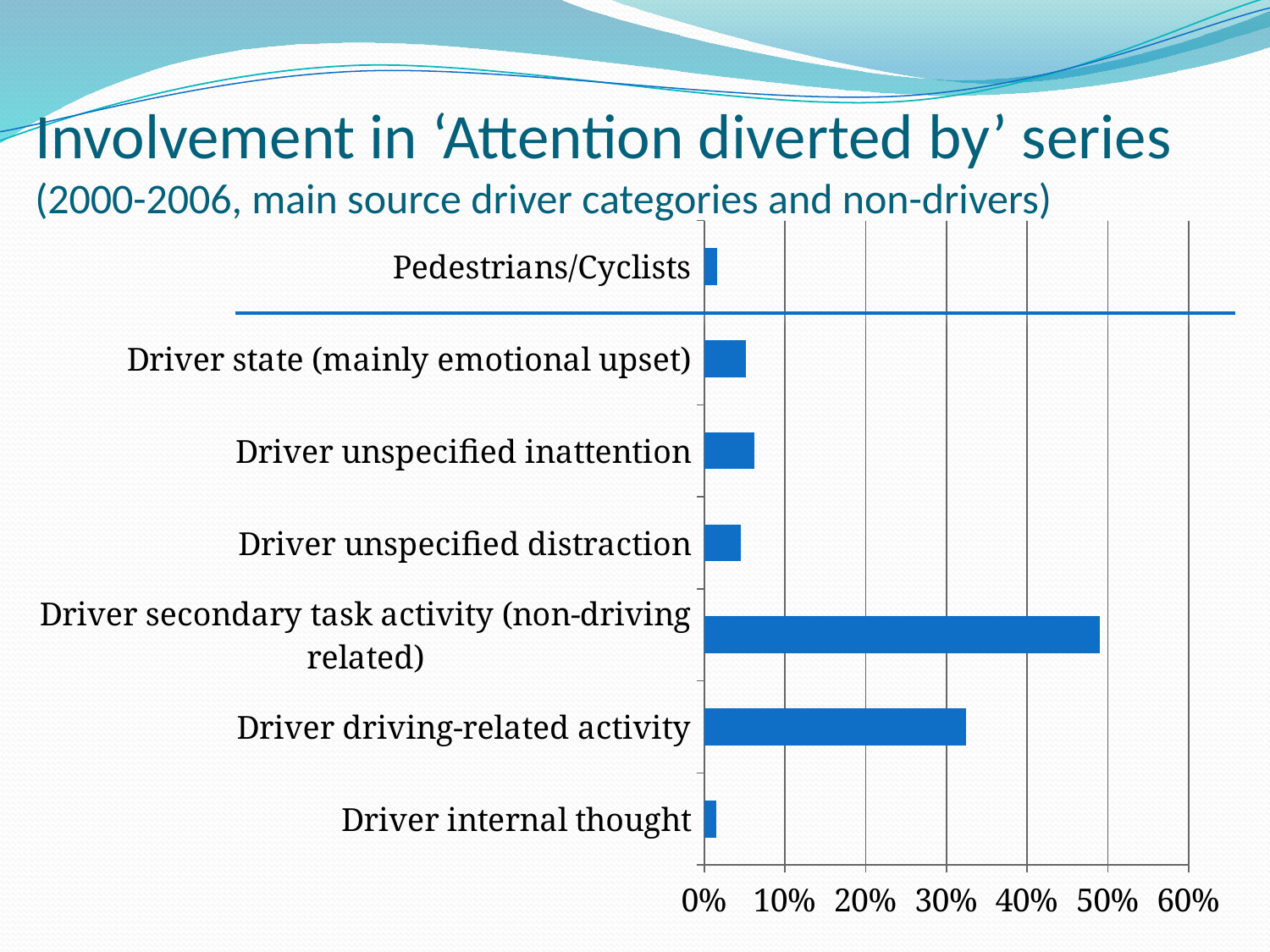
Is the value for Driver state (mainly emotional upset) greater or less than 10%? less What kind of chart is shown on the slide? bar chart Is the value for Driver driving-related activity greater or less than 40%? less Is the value for Driver secondary task activity (non-driving related) greater or less than 40%? greater Which category has the highest value in the chart? Driver secondary task activity (non-driving related) Which is larger: the value for Driver secondary task activity (non-driving related) or the value for Driver driving-related activity? Driver secondary task activity (non-driving related) What is the highest value shown on the horizontal axis of the chart? 60% Which is larger: the value for Driver driving-related activity or the value for Driver unspecified inattention? Driver driving-related activity How many categories are plotted in the chart? 7